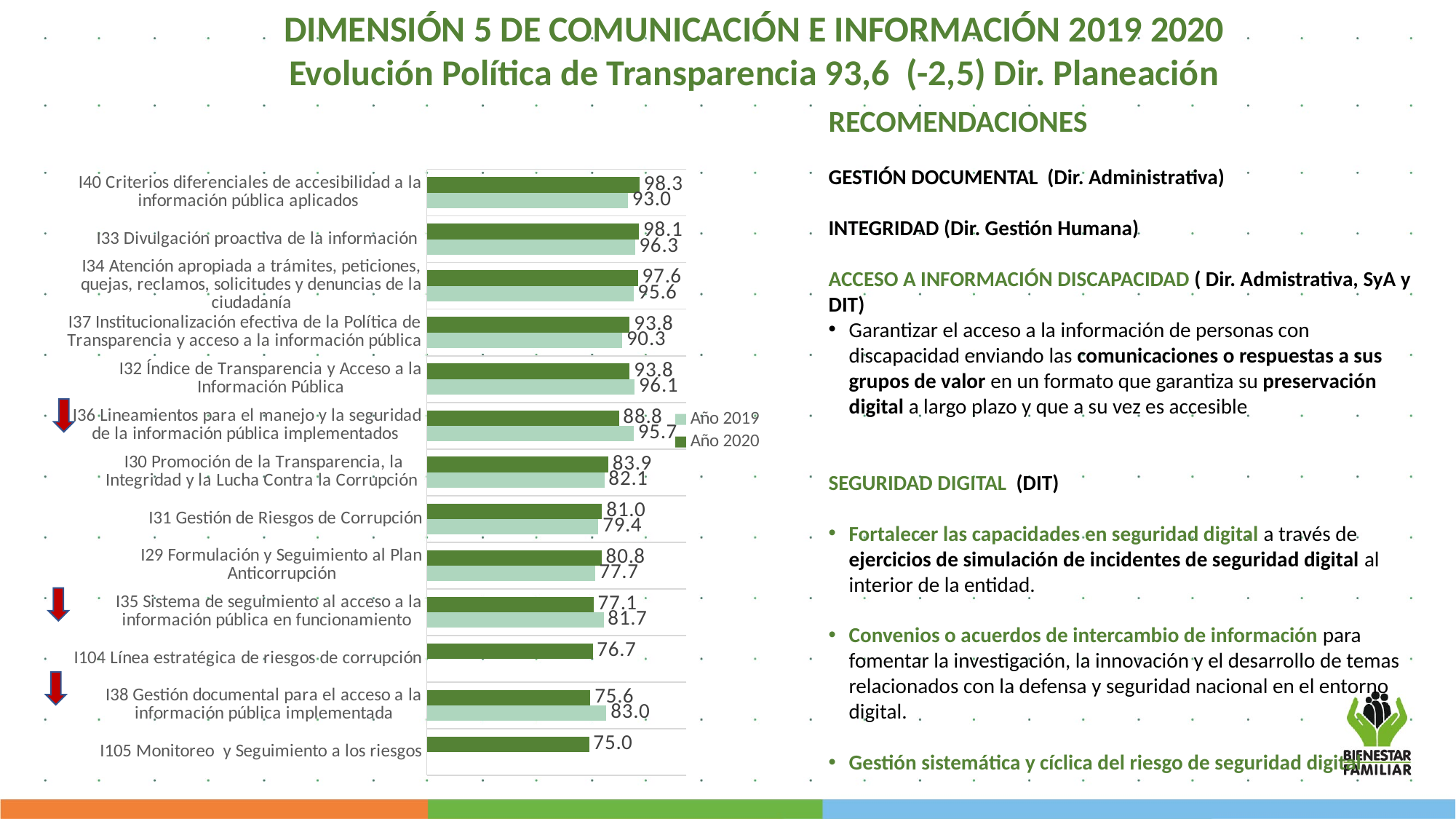
How many series does the legend list? 2 What is the difference between the Año 2019 and Año 2020 values for I36 Lineamientos para el manejo y la seguridad de la información pública implementados? 6.9 How many categories are shown in the chart? 13 What is the Año 2019 value for I33 Divulgación proactiva de la información? 96.3 Which category has the lowest Año 2019 value? I29 Formulación y Seguimiento al Plan Anticorrupción For I37 Institucionalización efectiva de la Política de Transparencia y acceso a la información pública, which is larger: the Año 2019 value or the Año 2020 value? Año 2020 Which series is shown in dark green in the chart? Año 2020 What is the Año 2020 value for I40 Criterios diferenciales de accesibilidad a la información pública aplicados? 98.3 For I38 Gestión documental para el acceso a la información pública implementada, which is larger: the Año 2019 value or the Año 2020 value? Año 2019 Which category has the highest Año 2020 value? I40 Criterios diferenciales de accesibilidad a la información pública aplicados What is the Año 2020 value for I105 Monitoreo y Seguimiento a los riesgos? 75.0 What kind of chart is shown on the slide? Bar chart